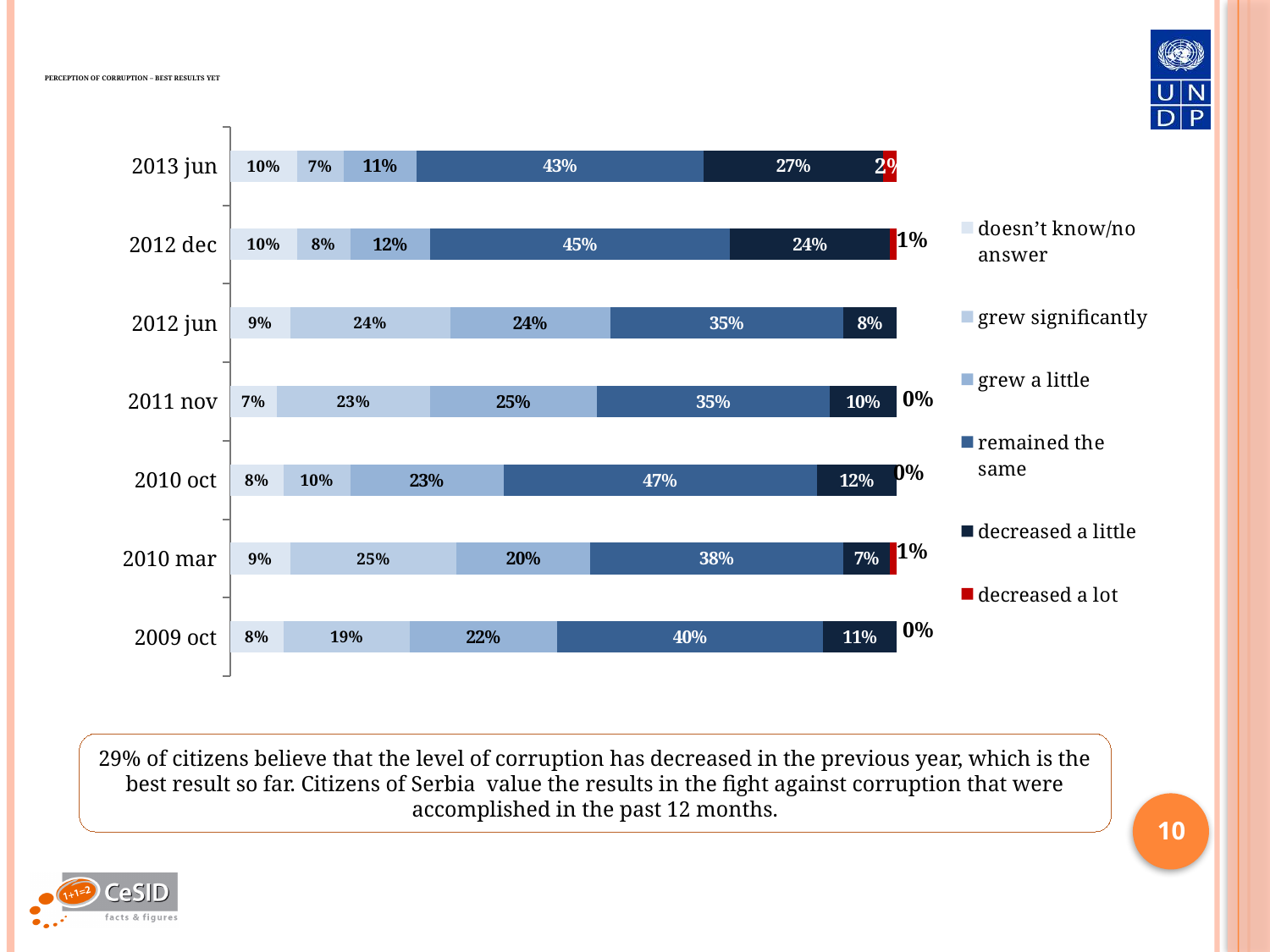
What is the difference between the 'decreased a little' values for 2013 jun and 2009 oct? 16 percentage points How many survey periods (categories) are shown on the chart? 7 What is the 'doesn't know/no answer' value for 2011 nov? 7% Which is larger: the 'grew significantly' value for 2012 jun or for 2013 jun? 2012 jun In which survey period is the 'decreased a little' share the lowest? 2010 mar What is the value for 'grew significantly' in 2010 mar? 25% What is the value for 'decreased a little' in 2012 dec? 24% What kind of chart is shown on the slide? Stacked bar chart What colour represents 'decreased a lot' in the legend? Red In which survey period is the 'remained the same' share the highest? 2010 oct What percentage of respondents in 2013 jun said corruption remained the same? 43% How many series does the legend list? 6